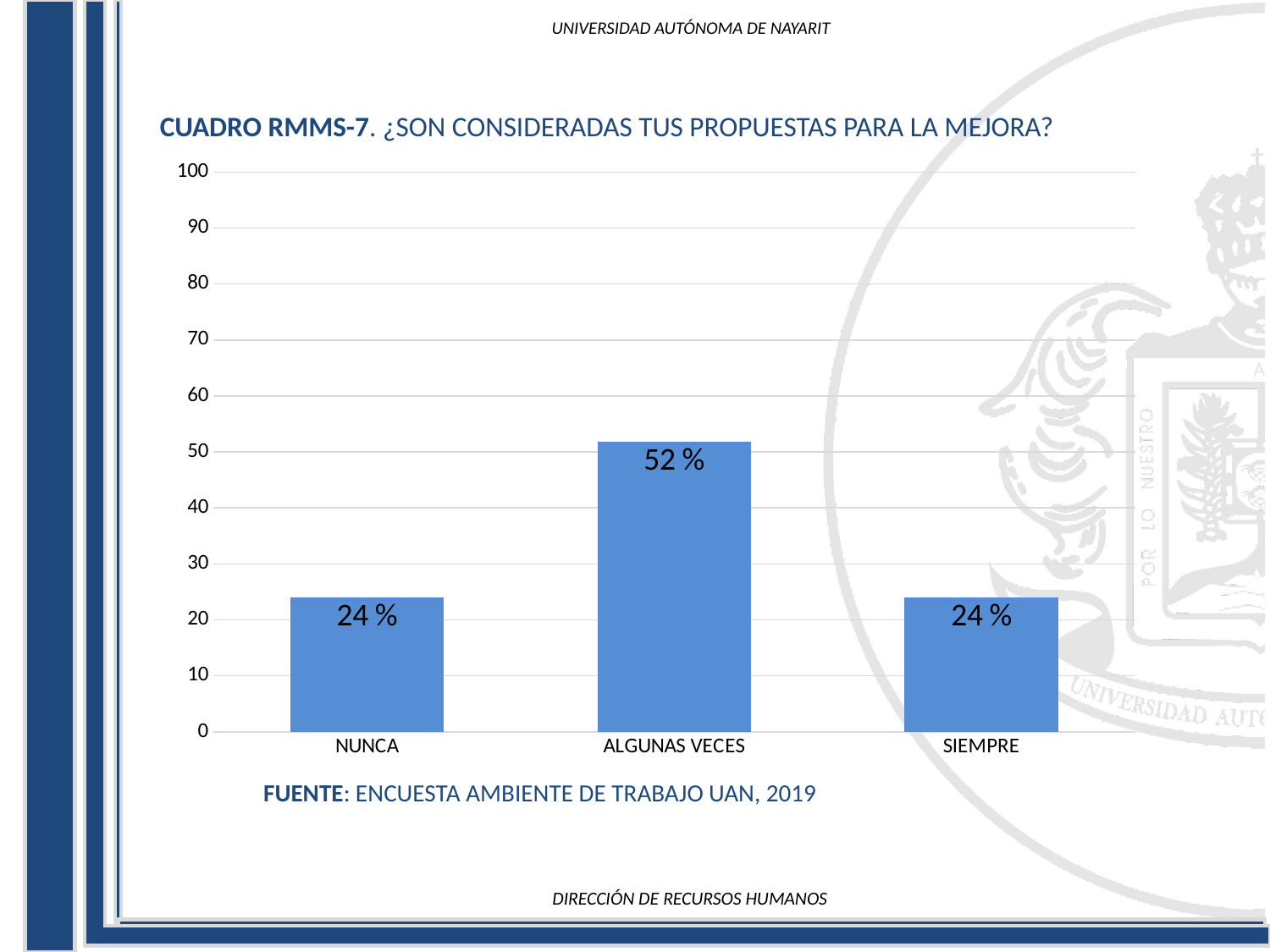
Which category has the highest value? ALGUNAS VECES How many categories are shown on the x axis? 3 Which is larger, the value for ALGUNAS VECES or the value for SIEMPRE? ALGUNAS VECES What is the total of the values for NUNCA and SIEMPRE? 48 % What is the difference between the values for ALGUNAS VECES and NUNCA? 28 % What is the value for NUNCA? 24 % What is the value for SIEMPRE? 24 % What kind of chart is shown on the slide? bar chart Is the value for ALGUNAS VECES greater or less than 50? greater What is the value for ALGUNAS VECES? 52 % What source is cited below the chart? ENCUESTA AMBIENTE DE TRABAJO UAN, 2019 Is the value for NUNCA greater or less than 30? less